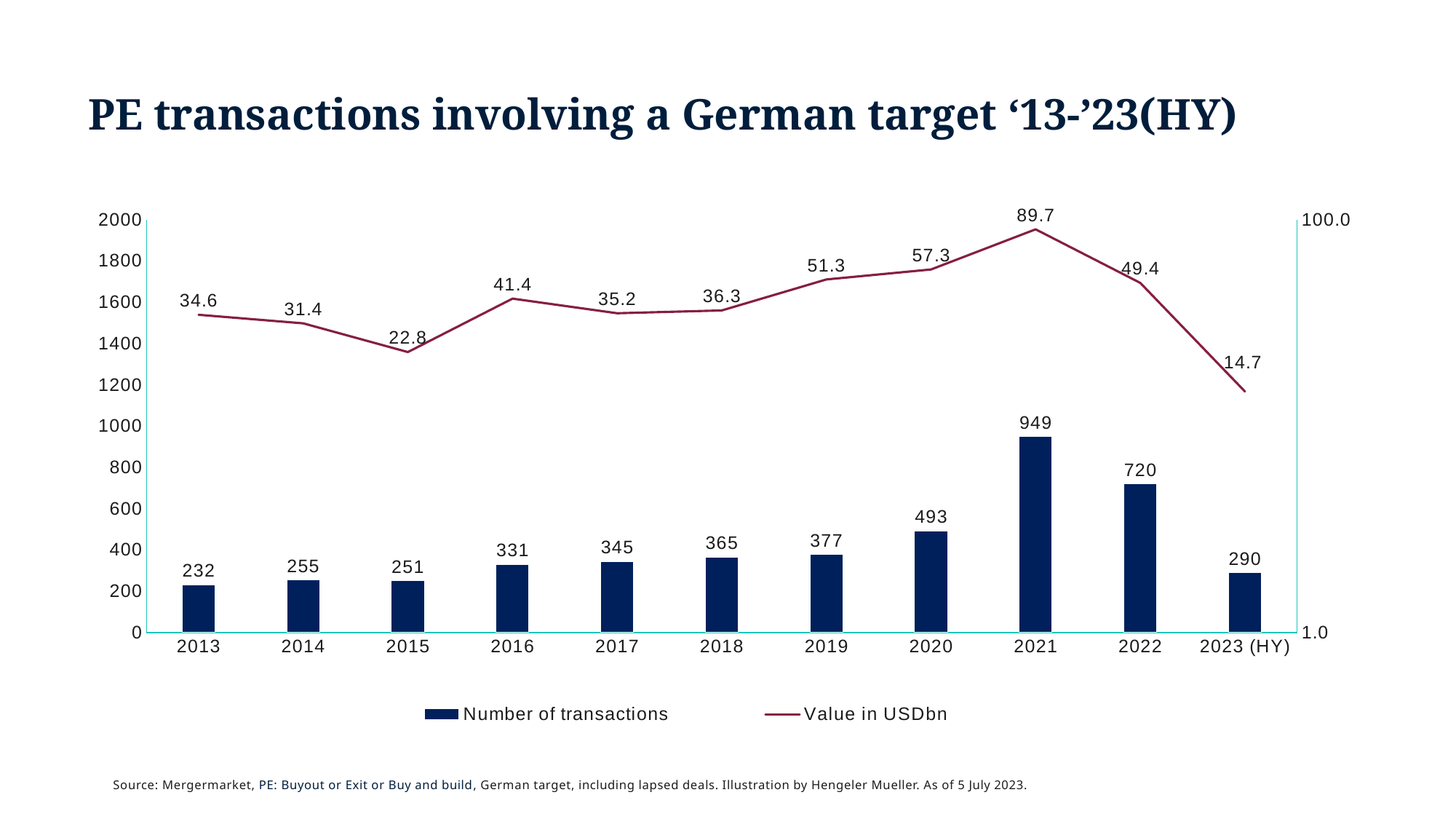
What is the difference in the number of transactions between 2021 and 2022? 229 How many series does the legend list? 2 Which year has the highest number of transactions? 2021 What is the title of the chart? PE transactions involving a German target ‘13-’23(HY) What is the value in USDbn for 2015? 22.8 What is the difference in value in USDbn between 2021 and 2023 (HY)? 75.0 Which year has the larger value in USDbn, 2019 or 2020? 2020 How many years are shown on the x axis? 11 Which year has the lowest value in USDbn? 2023 (HY) What is the number of transactions in 2021? 949 Does the number of transactions rise or fall from 2013 to 2021? Rise What kind of chart is used for the number of transactions? Bar chart